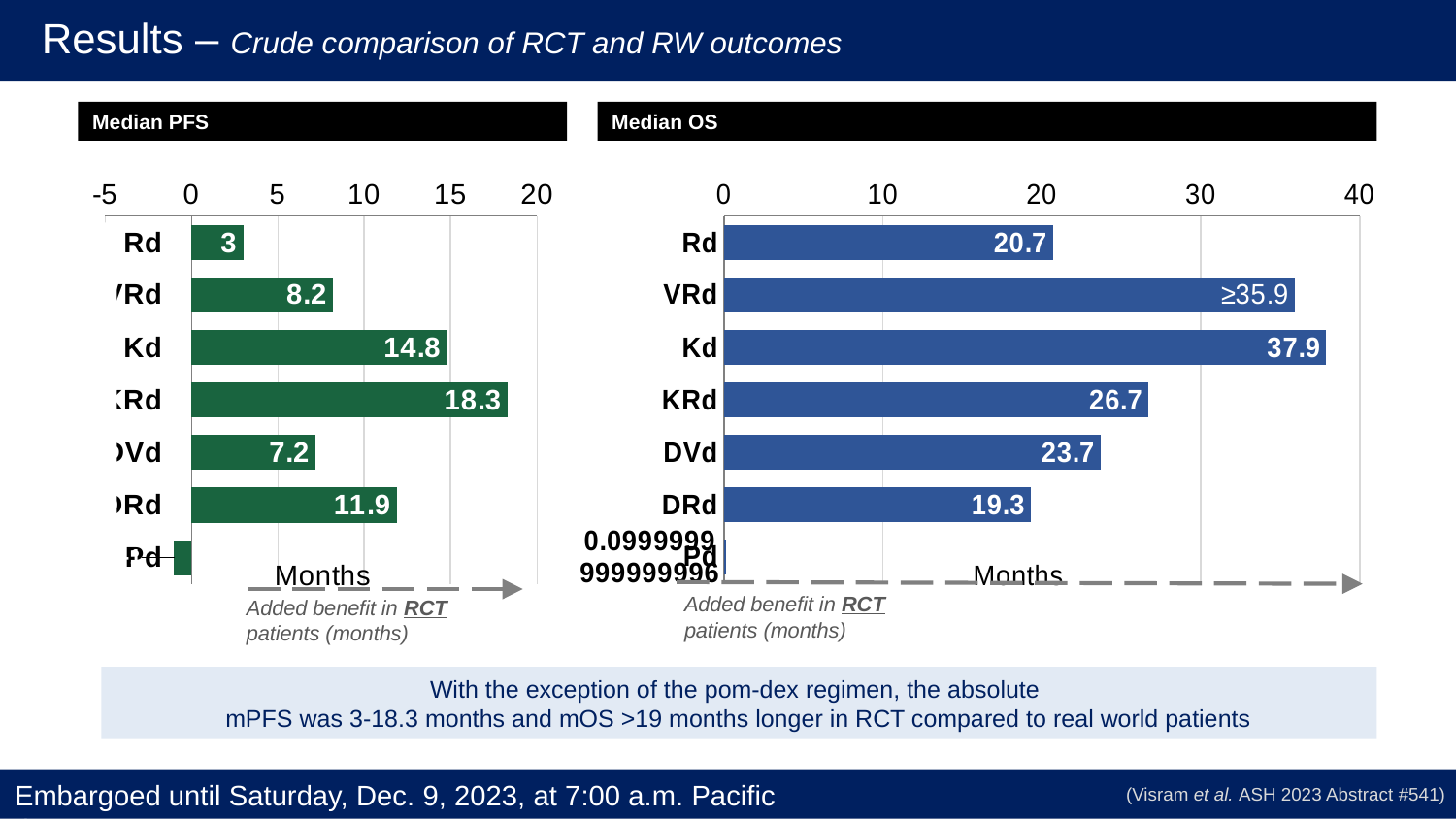
How many bars does the Median OS chart show? 7 In the Median PFS chart, what is the value for Kd? 14.8 In the Median OS chart, is the value for KRd greater or less than 20? greater In the Median OS chart, which is larger, the value for DVd or the value for DRd? DVd In the Median OS chart, what is the value for DRd? 19.3 In the Median OS chart, which category has the highest value? Kd In the Median PFS chart, what is the value for Rd? 3 In the Median OS chart, what is the value for Rd? 20.7 In the Median OS chart, what is the difference between the values for Kd and Rd? 17.2 In the Median OS chart, which category has the lowest value? Pd In the Median OS chart, what is the value shown for VRd? ≥35.9 In the Median OS chart, what is the value for Kd? 37.9